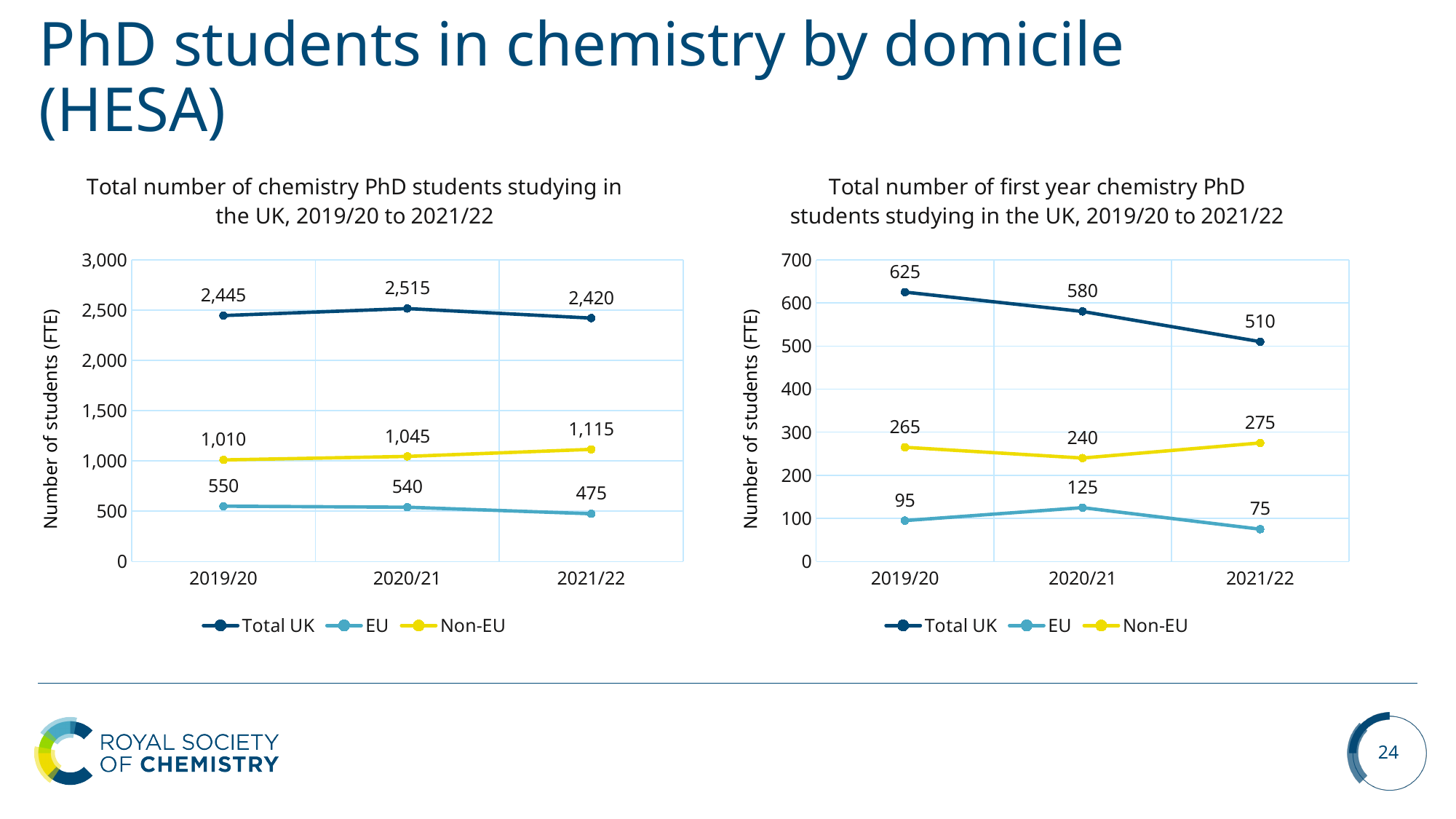
In the left chart (Total number of chemistry PhD students studying in the UK), in which year is the Non-EU value highest? 2021/22 In the right chart (Total number of first year chemistry PhD students), what is the difference between the EU values for 2020/21 and 2021/22? 50 In the right chart (Total number of first year chemistry PhD students), which is larger: the Non-EU value for 2019/20 or the Non-EU value for 2020/21? 2019/20 In the left chart (Total number of chemistry PhD students studying in the UK), what is the difference between the Total UK values for 2020/21 and 2021/22? 95 In the right chart (Total number of first year chemistry PhD students), what is the Non-EU value for 2021/22? 275 In the left chart (Total number of chemistry PhD students studying in the UK), what is the Total UK value for 2020/21? 2,515 How many series does the legend of the left chart list? 3 How many years are plotted on the x axis of the right chart? 3 In the right chart (Total number of first year chemistry PhD students), does the Total UK value rise or fall from 2019/20 to 2021/22? fall What kind of chart is the left chart (Total number of chemistry PhD students studying in the UK)? line chart In the left chart (Total number of chemistry PhD students studying in the UK), what is the EU value for 2021/22? 475 In the right chart (Total number of first year chemistry PhD students), in which year is the Total UK value lowest? 2021/22